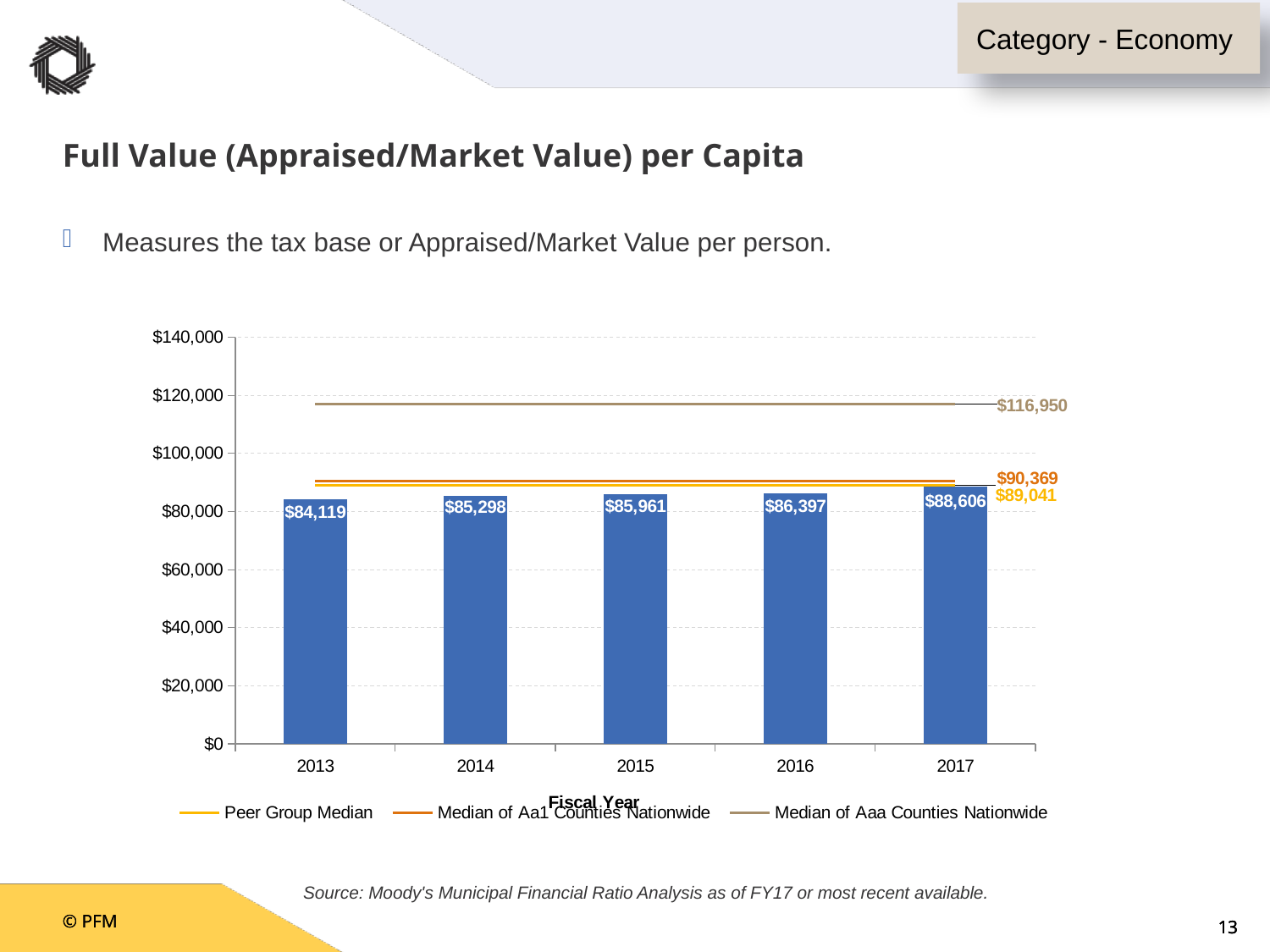
What is the Full Value per Capita for fiscal year 2013? $84,119 Which is larger, the Median of Aa1 Counties Nationwide or the Peer Group Median? Median of Aa1 Counties Nationwide What is the difference between the 2017 and 2013 Full Value per Capita values? $4,487 What is the Full Value per Capita for fiscal year 2017? $88,606 How many series does the legend list? 3 Which fiscal year has the highest Full Value per Capita bar? 2017 What value is shown for the Peer Group Median line? $89,041 What is the Full Value per Capita for fiscal year 2015? $85,961 How many fiscal years are shown on the x axis? 5 Which fiscal year has the lowest Full Value per Capita bar? 2013 Do the Full Value per Capita bars rise or fall from 2013 to 2017? rise What value is shown for the Median of Aaa Counties Nationwide line? $116,950